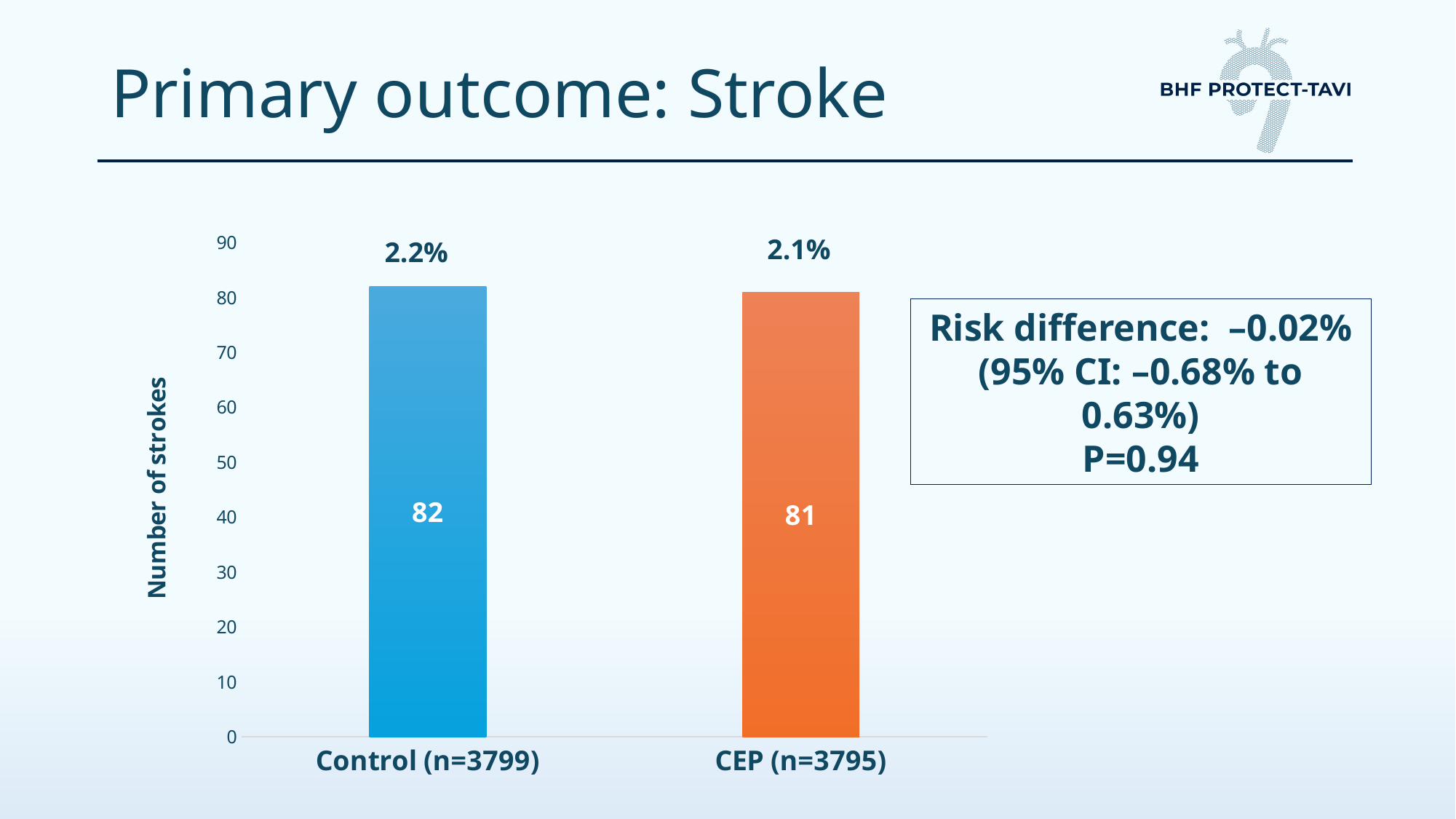
What colour is the bar for CEP (n=3795)? orange How many categories are shown on the x axis? 2 What percentage is shown above the Control (n=3799) bar? 2.2% What percentage is shown above the CEP (n=3795) bar? 2.1% What is the number of strokes for Control (n=3799)? 82 What is the number of strokes for CEP (n=3795)? 81 What is the difference in number of strokes between Control (n=3799) and CEP (n=3795)? 1 Is the number of strokes for Control (n=3799) greater or less than 70? greater What is the label of the y axis? Number of strokes What kind of chart is shown on the slide? bar chart Is the number of strokes for CEP (n=3795) greater or less than 90? less